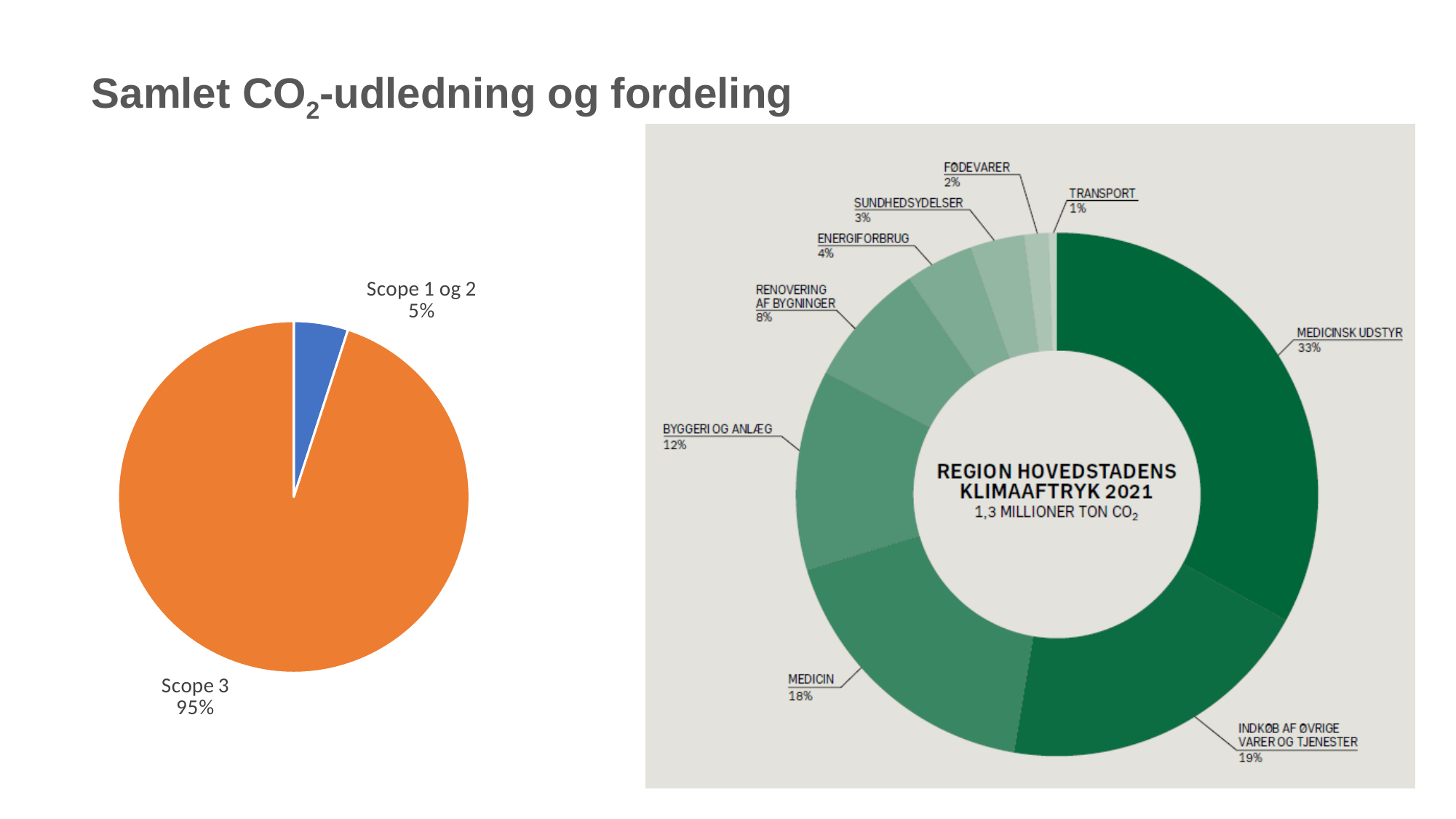
What kind of chart is the chart on the left? Pie chart In the pie chart on the left, what is the value for Scope 3? 95% In the donut chart on the right (Region Hovedstadens Klimaaftryk 2021), what is the share for Medicinsk udstyr? 33% In the donut chart on the right, what total CO2 amount is stated in the centre? 1,3 millioner ton CO2 In the donut chart on the right, which category has the smallest share? Transport In the pie chart on the left, which category has the largest share? Scope 3 In the pie chart on the left, how many slices are there? 2 In the donut chart on the right, which is larger: Byggeri og anlæg or Renovering af bygninger? Byggeri og anlæg In the pie chart on the left, what is the value for Scope 1 og 2? 5% In the pie chart on the left, what is the difference between Scope 3 and Scope 1 og 2? 90 percentage points In the donut chart on the right, how many categories are shown? 9 In the donut chart on the right, what is the share for Medicin? 18%